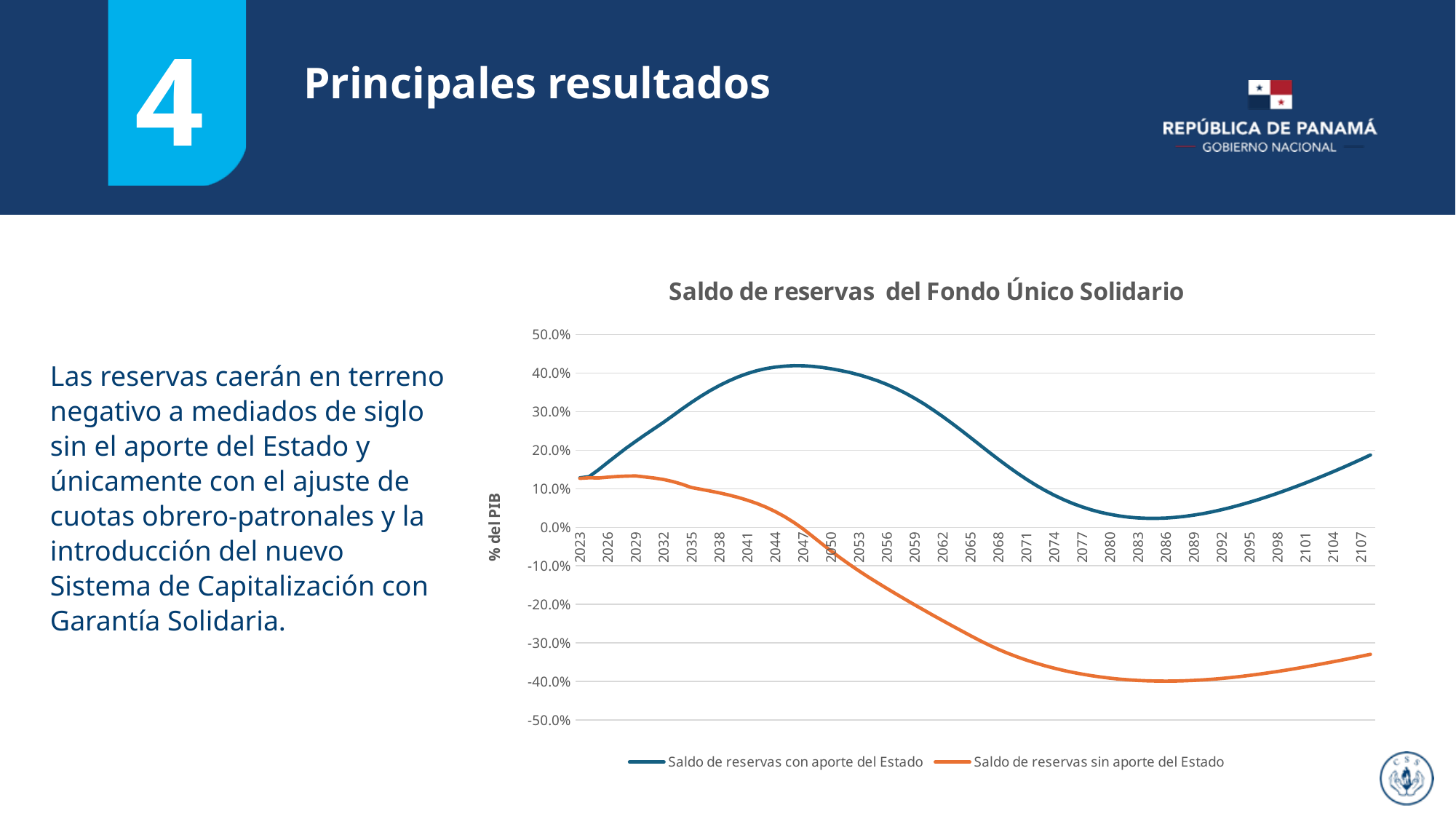
What kind of chart is shown on the slide? line chart Is the value for 'Saldo de reservas sin aporte del Estado' in 2041 greater or less than 10.0%? less Is the value for 'Saldo de reservas con aporte del Estado' in 2047 greater or less than 40.0%? greater How many series does the legend list? 2 Is the value for 'Saldo de reservas sin aporte del Estado' in 2071 greater or less than -30.0%? less What is the title of the chart? Saldo de reservas del Fondo Único Solidario In 2107, which series has the higher value: 'Saldo de reservas con aporte del Estado' or 'Saldo de reservas sin aporte del Estado'? Saldo de reservas con aporte del Estado Which series reaches the lowest value on the chart? Saldo de reservas sin aporte del Estado Does the 'Saldo de reservas sin aporte del Estado' series rise or fall between 2029 and 2086? fall What is the label on the vertical axis of the chart? % del PIB How many year labels are shown along the x axis? 29